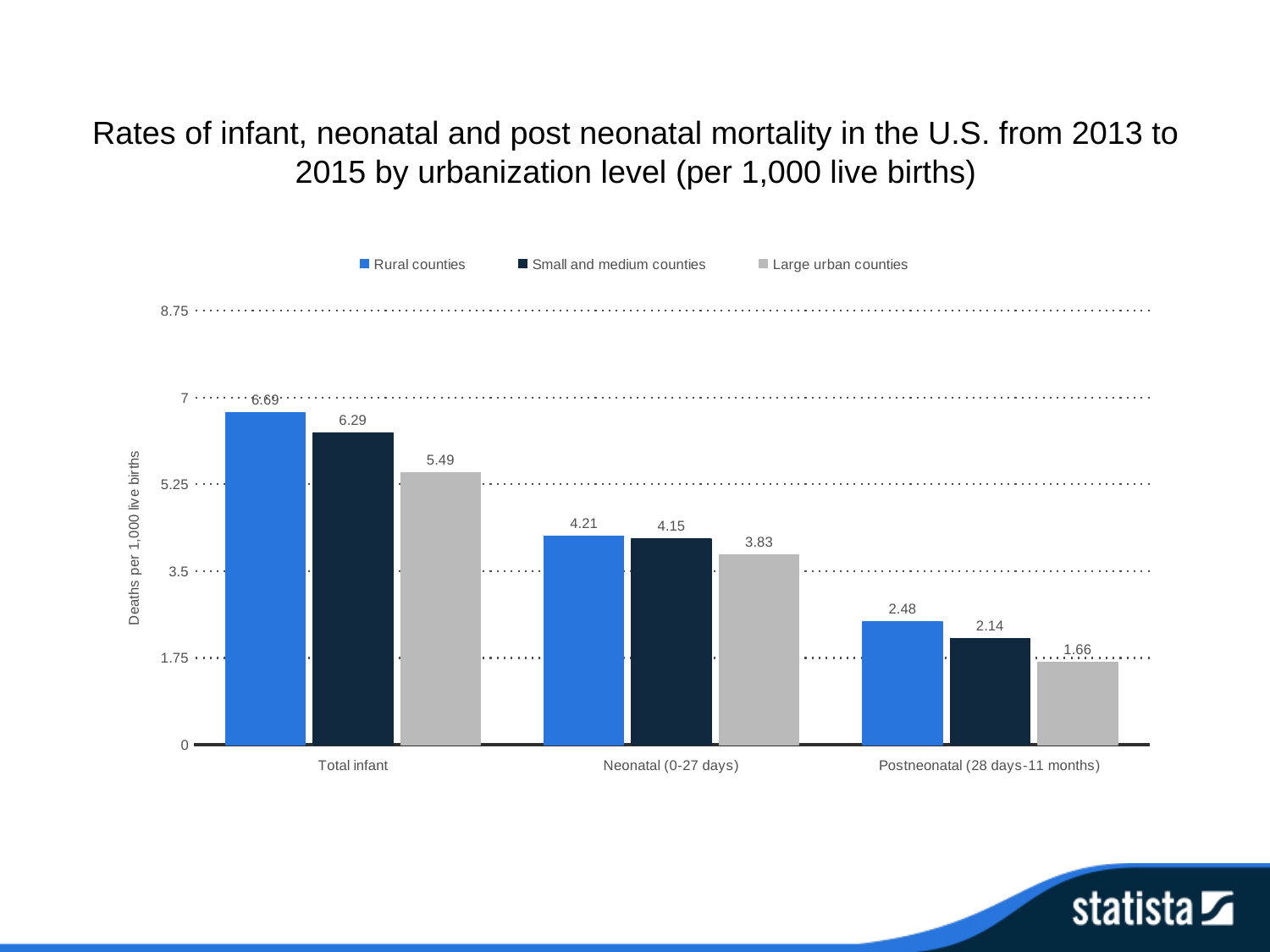
What is the label of the y axis? Deaths per 1,000 live births Is the value for small and medium counties in the Total infant category greater or less than 7? less Which is larger in the Neonatal (0-27 days) category: rural counties or large urban counties? Rural counties What kind of chart is shown on the slide? Bar chart What is the value for large urban counties in the Neonatal (0-27 days) category? 3.83 How many categories are shown on the x axis? 3 What is the value for small and medium counties in the Postneonatal (28 days-11 months) category? 2.14 What is the infant mortality rate for rural counties in the Total infant category? 6.69 Which series has the lowest value in the Postneonatal (28 days-11 months) category? Large urban counties What is the difference between the rural counties and large urban counties values in the Total infant category? 1.2 How many series does the legend list? 3 Which category has the highest value for rural counties? Total infant